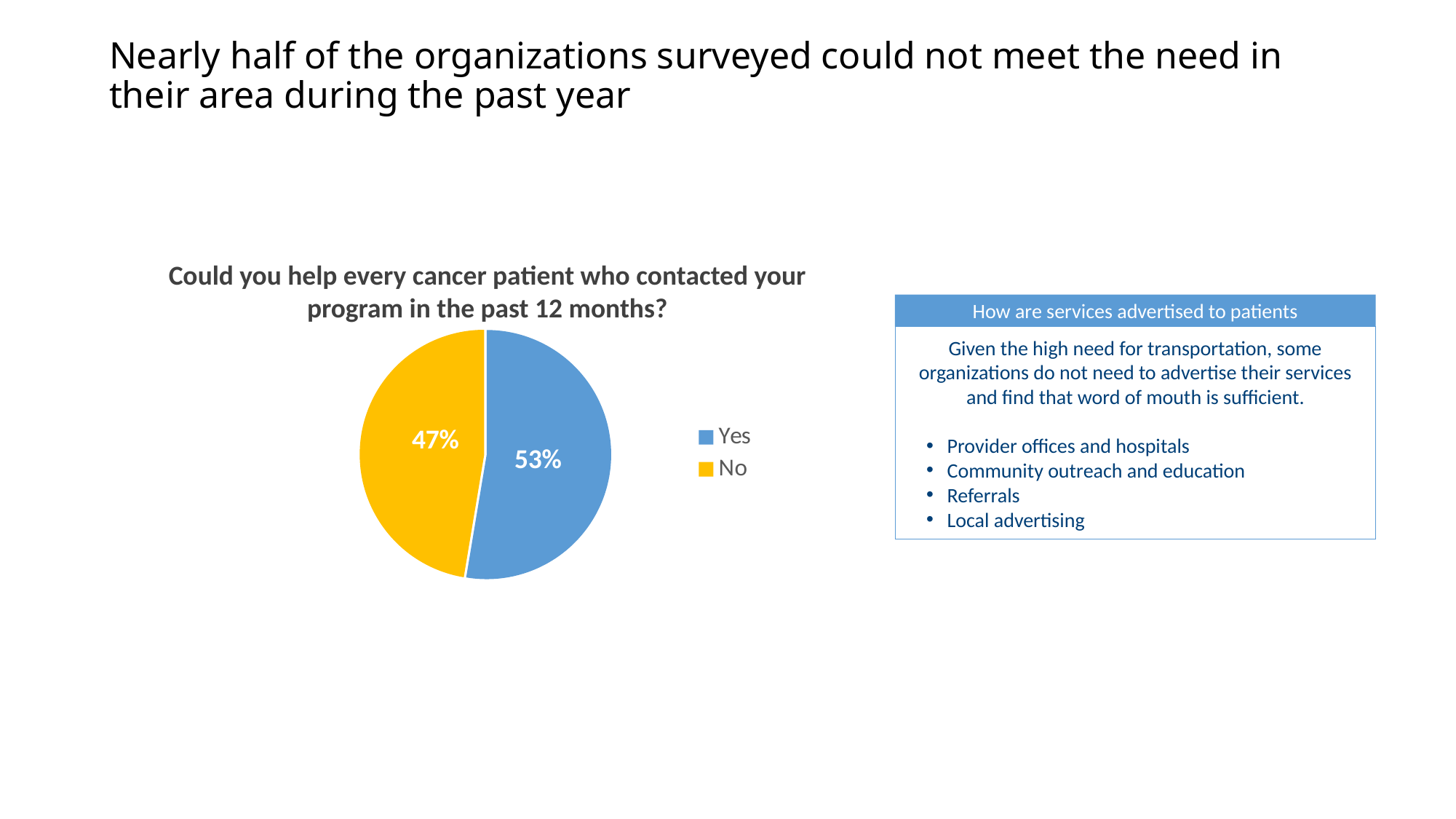
Which response has the larger share of the pie, Yes or No? Yes Is the share for Yes greater or less than 50%? greater What percentage of organizations answered Yes to whether they could help every cancer patient who contacted their program in the past 12 months? 53% How many slices does the pie chart have? 2 Which category has the smallest slice in the pie chart? No What kind of chart is shown on the slide? Pie chart Which category has the largest slice in the pie chart? Yes How many entries does the chart legend list? 2 What is the title of the pie chart? Could you help every cancer patient who contacted your program in the past 12 months? What colour is the No slice in the pie chart? Yellow What percentage of organizations answered No to whether they could help every cancer patient who contacted their program in the past 12 months? 47% What is the difference in percentage points between the Yes and No slices? 6%